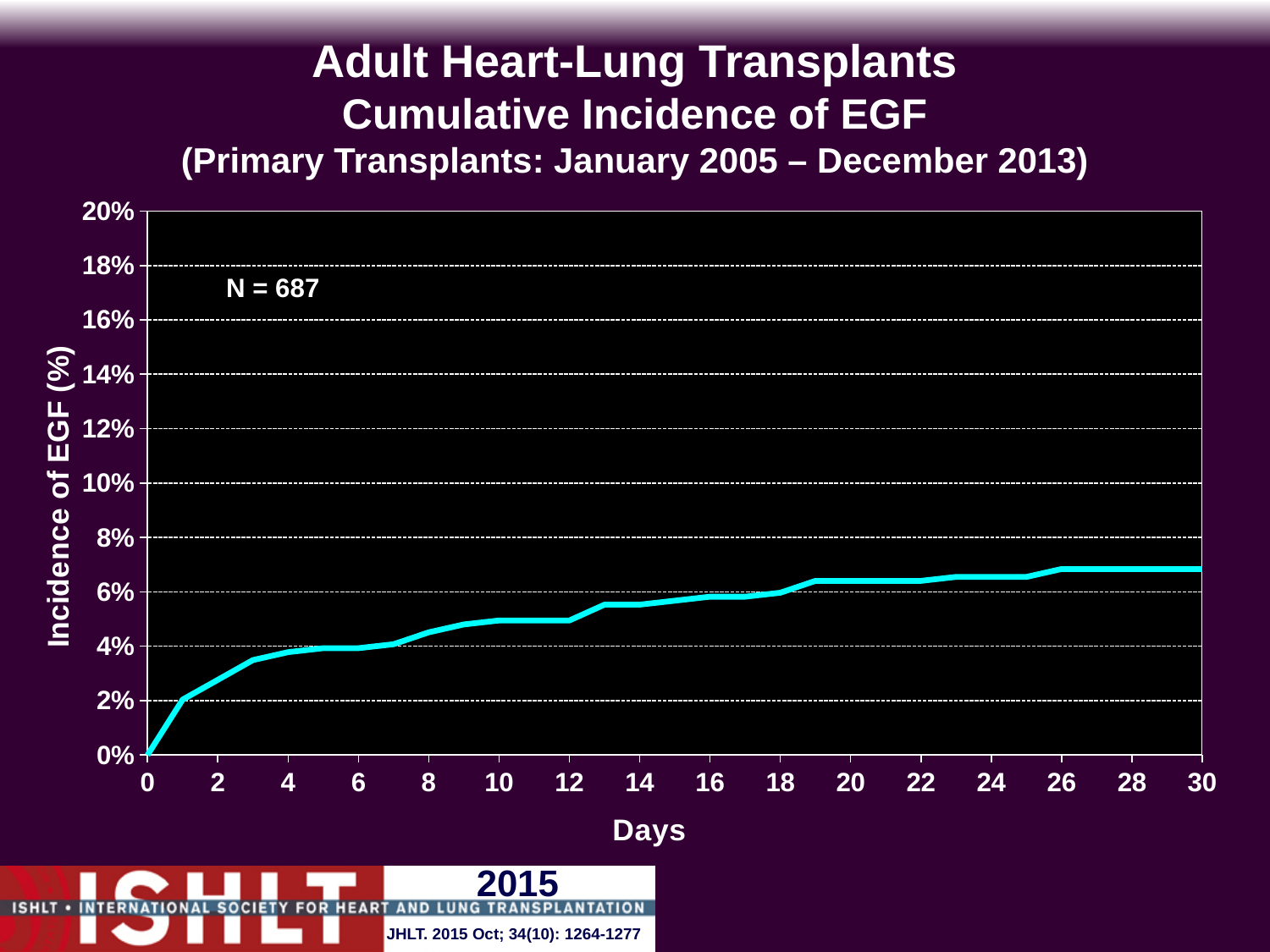
What is the cumulative incidence of EGF at day 0? 0% What kind of chart is shown on the slide? line chart At which day is the cumulative incidence of EGF lowest? 0 Is the cumulative incidence of EGF at day 20 greater or less than 6%? greater Is the cumulative incidence of EGF at day 10 greater or less than 6%? less Is the cumulative incidence of EGF at day 10 greater or less than 4%? greater What sample size (N) is printed on the chart? N = 687 Which is larger, the cumulative incidence of EGF at day 4 or at day 14? day 14 Does the cumulative incidence of EGF rise or fall as the number of days increases? rise What is the title of the chart? Adult Heart-Lung Transplants Cumulative Incidence of EGF (Primary Transplants: January 2005 – December 2013)